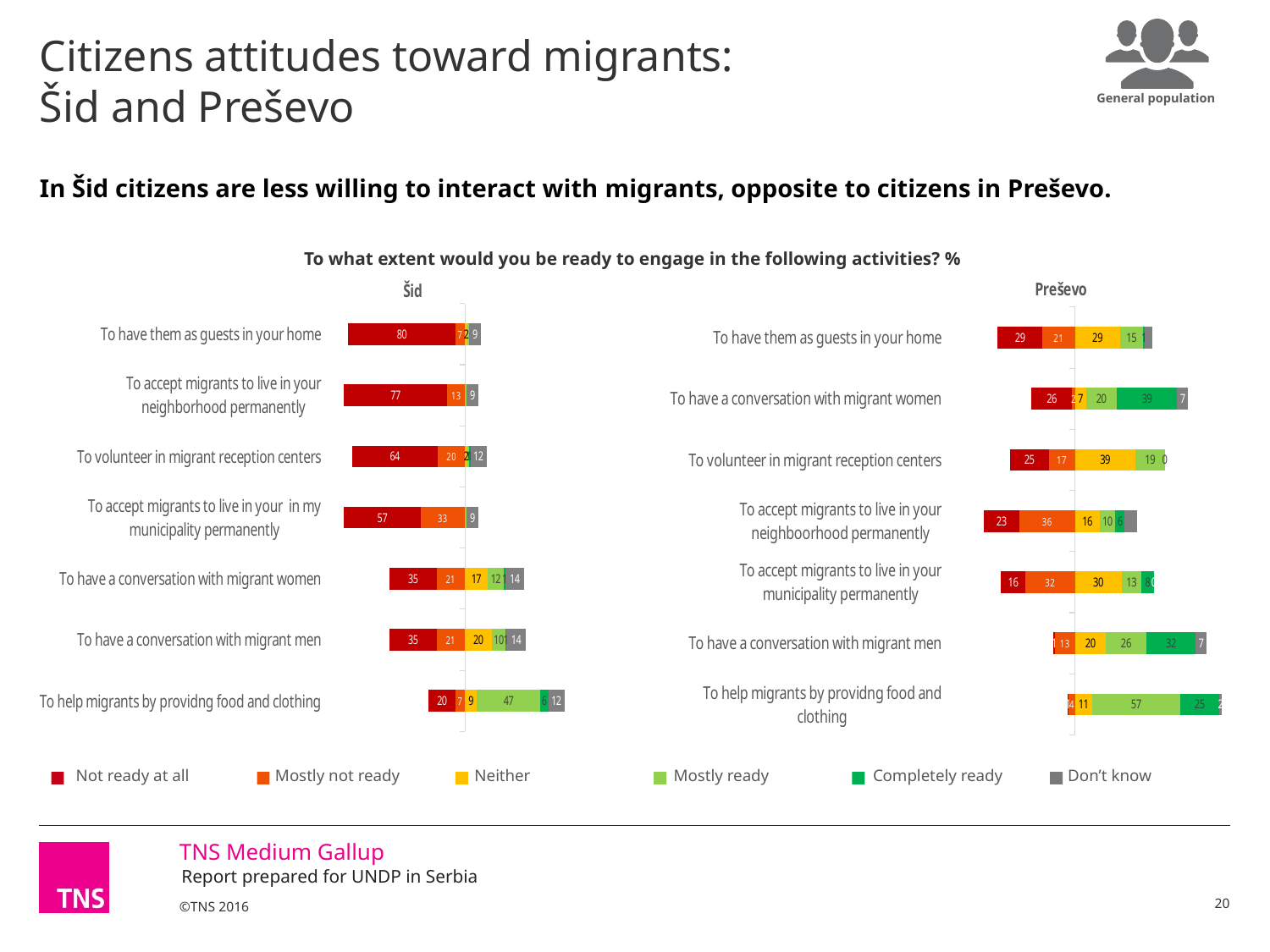
In the Preševo chart, what percentage of citizens are 'Mostly ready' to help migrants by providing food and clothing? 57 In the Šid chart, what percentage of citizens are 'Not ready at all' to have migrants as guests in their home? 80 How many response categories does the legend list? 6 In the Preševo chart, what percentage of citizens are 'Completely ready' to have a conversation with migrant women? 39 In the Šid chart, which activity has the lowest 'Not ready at all' percentage? To help migrants by providng food and clothing In the Šid chart, what is the difference between the 'Not ready at all' percentage for having migrants as guests in your home (80) and for helping migrants by providing food and clothing (20)? 60 In the Šid chart, which activity has the highest 'Not ready at all' percentage? To have them as guests in your home Which is larger: the 'Not ready at all' percentage for having migrants as guests in your home in Šid, or in Preševo? Šid In the Šid chart, what percentage of citizens are 'Mostly ready' to help migrants by providing food and clothing? 47 What type of chart is used for the Šid and Preševo data? Stacked bar chart How many activities are listed in the Šid chart? 7 In the Preševo chart, what percentage of citizens are 'Neither' ready nor not ready to volunteer in migrant reception centers? 39